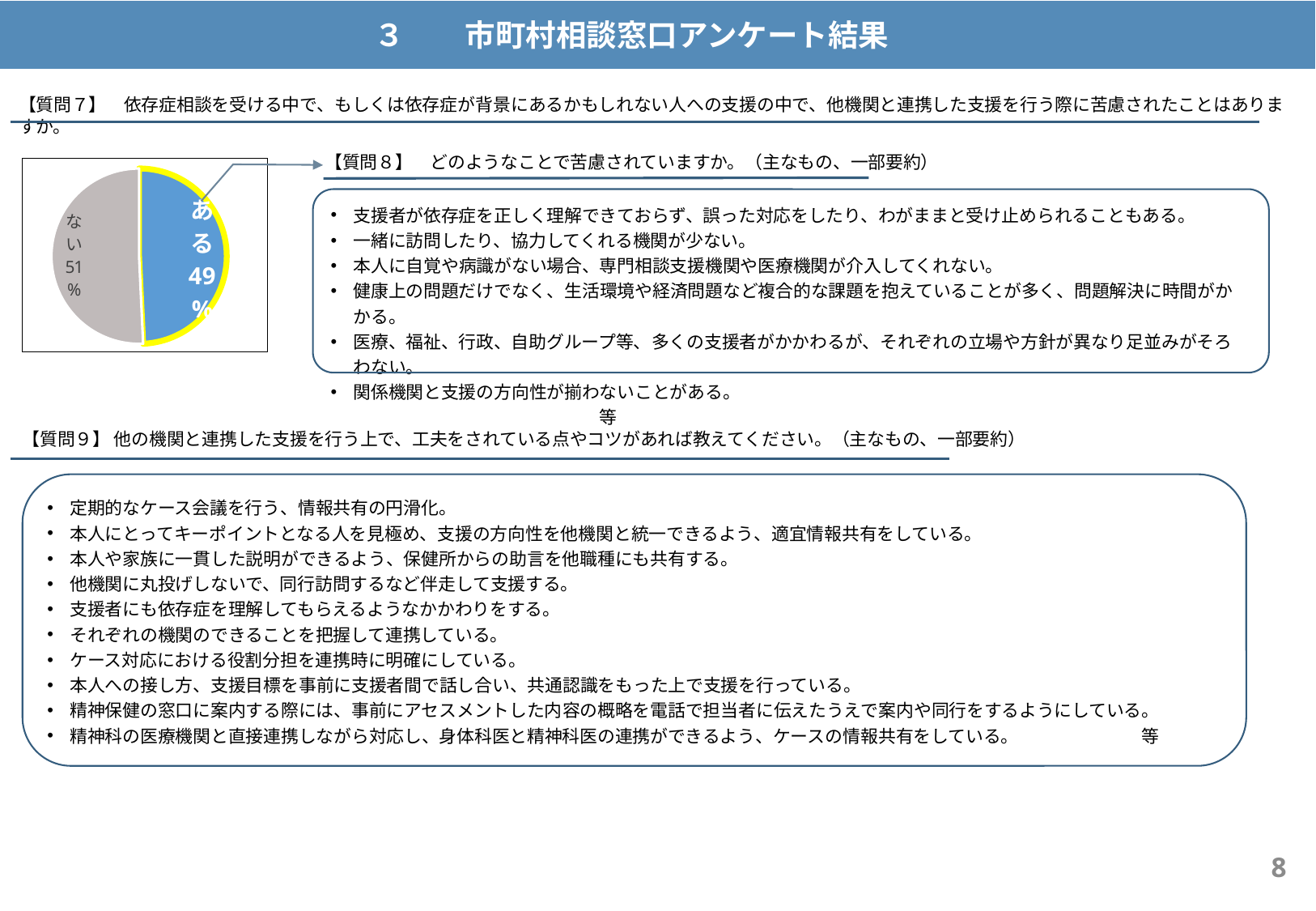
What percentage of the pie chart is labelled ある? 49% What colour is the ない slice of the pie chart? grey What colour is the ある slice of the pie chart? blue What is the difference between the ない share and the ある share in the pie chart? 2% What percentage of the pie chart is labelled ない? 51% How many slices does the pie chart have? 2 Which slice of the pie chart is the largest? ない Which slice of the pie chart is the smallest? ある Which is larger in the pie chart, ある or ない? ない Is the value for ない in the pie chart greater or less than 50%? greater What kind of chart is shown on the slide? pie chart What share of the pie does the ある slice represent? 49%